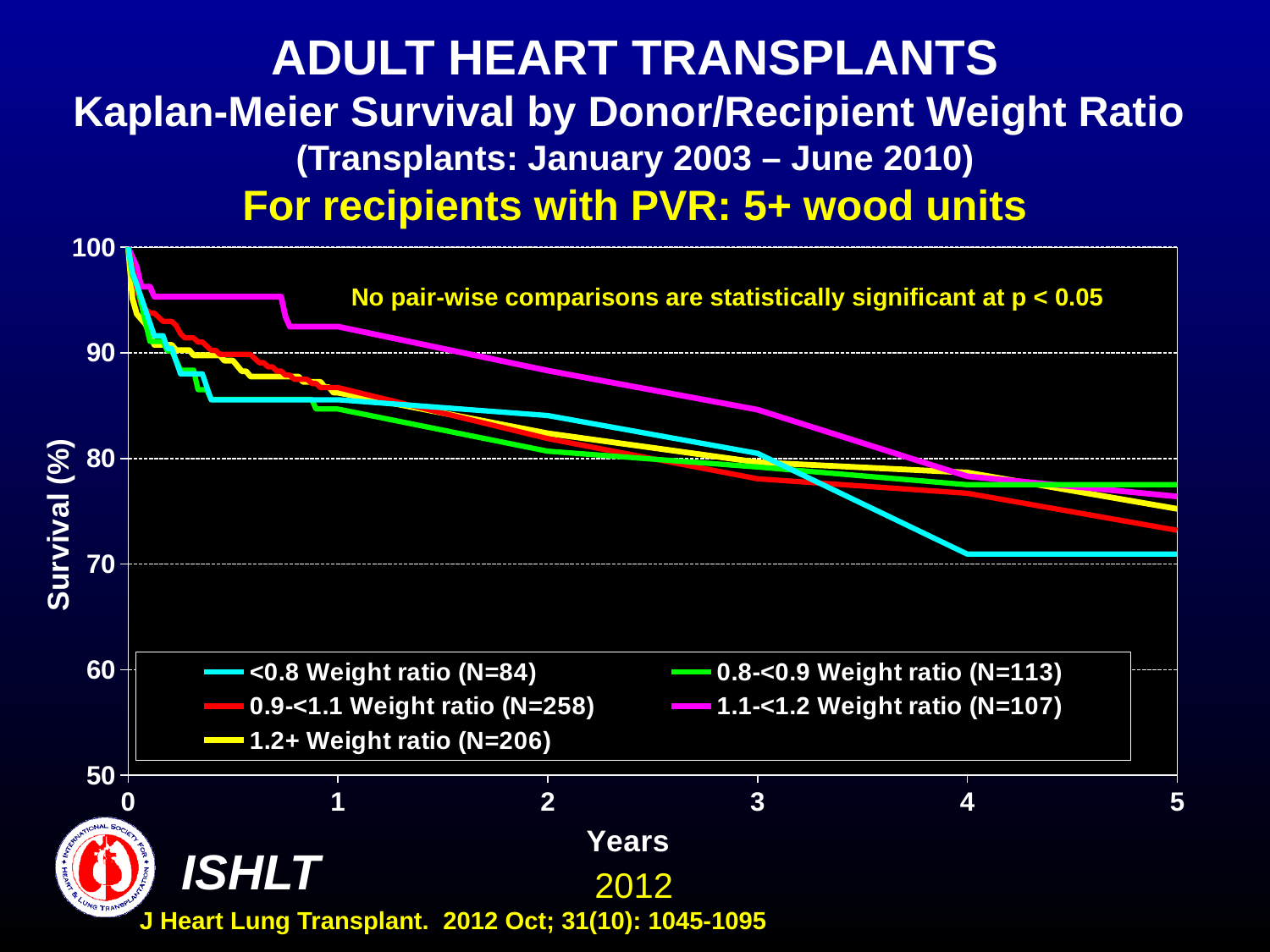
Do the survival curves rise or fall as years increase? fall What is the N for the 0.9-<1.1 Weight ratio group in the legend? N=258 Is the survival for the 0.9-<1.1 Weight ratio group at year 5 greater or less than 80? less What kind of chart is shown on the slide? Line chart Which weight ratio group has the lowest survival at year 5? <0.8 Weight ratio (N=84) How many series does the legend list? 5 Is the survival for the <0.8 Weight ratio group at year 5 greater or less than 80? less Which weight ratio group has the highest survival at year 2? 1.1-<1.2 Weight ratio (N=107) Is the survival for the 1.1-<1.2 Weight ratio group at year 1 greater or less than 90? greater What does the note on the chart say about pair-wise comparisons? No pair-wise comparisons are statistically significant at p < 0.05 At year 4, which has higher survival: the 1.1-<1.2 Weight ratio group or the <0.8 Weight ratio group? 1.1-<1.2 Weight ratio group What is the survival (%) for all weight ratio groups at year 0? 100